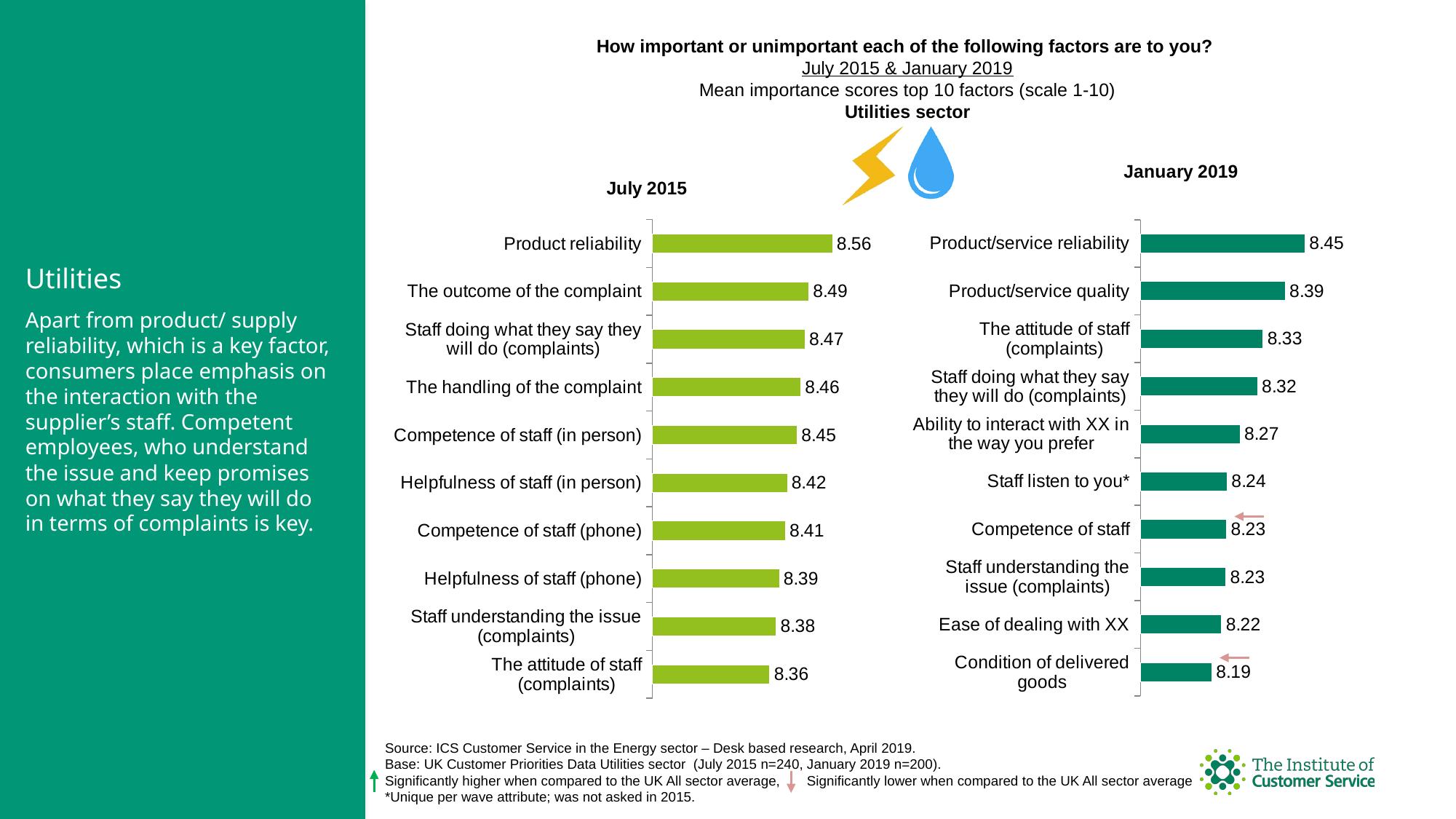
In the January 2019 chart, which factor has the lowest score? Condition of delivered goods In the January 2019 chart, what is the score for Ease of dealing with XX? 8.22 In the January 2019 chart, which factor has the highest score? Product/service reliability In the January 2019 chart, what is the difference between the scores for Product/service reliability and Condition of delivered goods? 0.26 What type of chart is used to show the July 2015 scores? Bar chart In the July 2015 chart, what is the difference between the scores for Product reliability and The attitude of staff (complaints)? 0.20 Which is higher: the July 2015 score for Competence of staff (phone) or the January 2019 score for Competence of staff? July 2015 Competence of staff (phone) In the July 2015 chart, what is the mean importance score for Product reliability? 8.56 In the January 2019 chart, do the scores rise or fall from top to bottom? Fall How many factors are shown in the July 2015 chart? 10 In the January 2019 chart, what is the mean importance score for Product/service quality? 8.39 In the July 2015 chart, which factor has the lowest score? The attitude of staff (complaints)